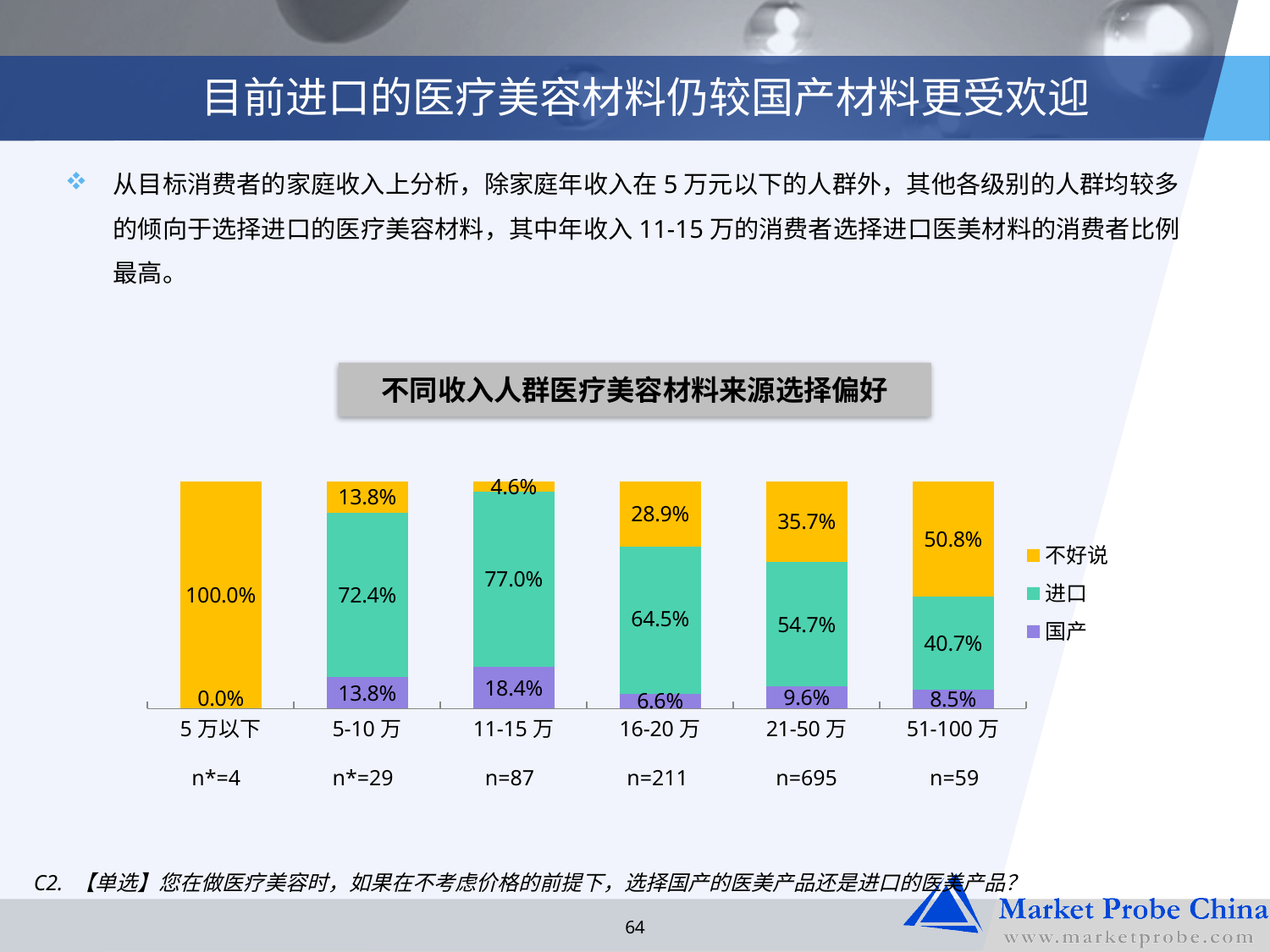
Which income group has the lowest 不好说 value? 11-15 万 How many series does the chart legend list? 3 What is the 进口 value for the 11-15 万 income group? 77.0% What is the difference between the 进口 values for the 5-10 万 and 51-100 万 groups? 31.7% Which is larger: the 国产 value for 21-50 万 or the 国产 value for 51-100 万? 21-50 万 What is the title of the chart? 不同收入人群医疗美容材料来源选择偏好 Which income group has the highest 进口 value? 11-15 万 What is the 不好说 value for the 51-100 万 income group? 50.8% What type of chart is shown on the slide? Stacked bar chart How many income categories are shown on the x axis of the chart? 6 What is the 国产 value for the 16-20 万 income group? 6.6% What is the sample size (n) shown for the 21-50 万 income group? n=695